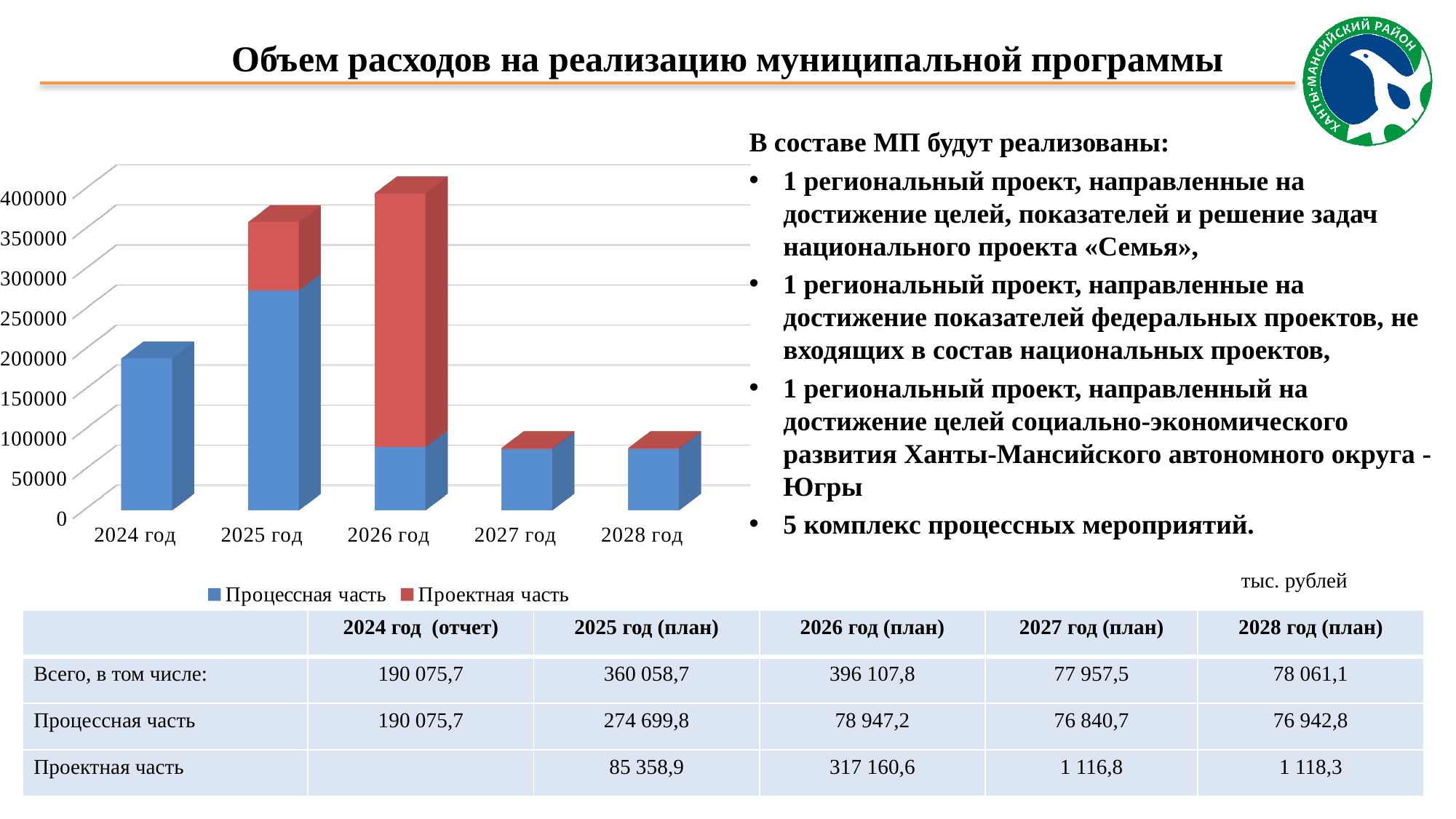
According to the table on the slide, what is the Всего value for 2026 год (план)? 396 107,8 Which year has the largest Процессная часть (blue) segment in the chart? 2025 год Is the Проектная часть segment for 2026 год greater or less than 250000? greater How many series does the chart legend list? 2 Which is larger in the chart: the total bar for 2025 год or the total bar for 2026 год? 2026 год Which year has the tallest stacked bar in the chart? 2026 год How many years (categories) are shown on the x axis of the chart? 5 What kind of chart is shown on the slide? stacked bar chart Which series is shown in red in the chart legend? Проектная часть According to the table on the slide, what is the Проектная часть value for 2025 год (план)? 85 358,9 Is the total stacked bar for 2027 год greater or less than 100000? less Is the total stacked bar for 2024 год greater or less than 150000? greater